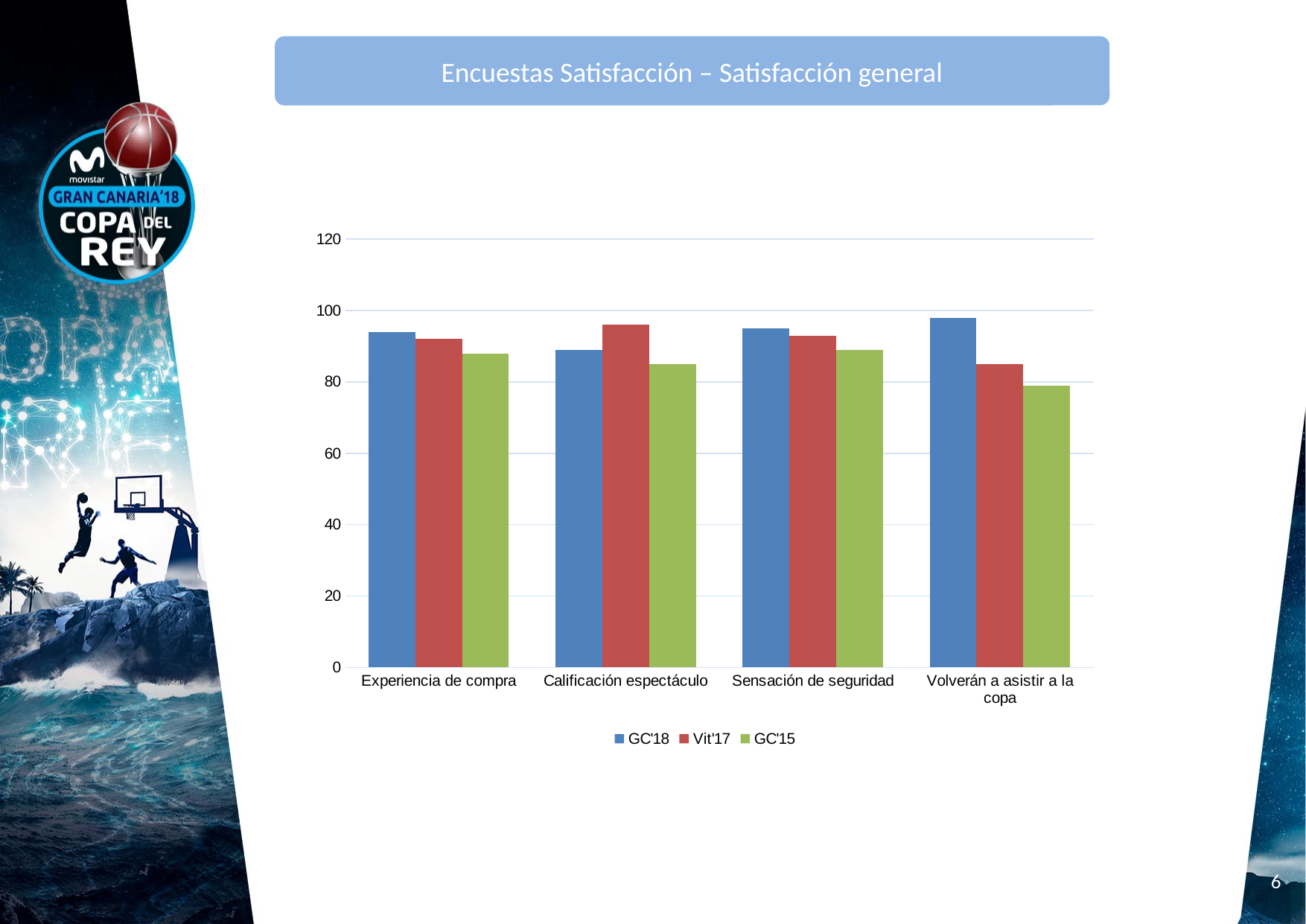
What is the title of the slide containing the chart? Encuestas Satisfacción – Satisfacción general For which category is the GC'18 value lowest? Calificación espectáculo How many series does the chart's legend list? 3 What kind of chart is shown on the slide? bar chart For Calificación espectáculo, which is larger: the GC'18 value or the Vit'17 value? Vit'17 For which category is the GC'15 value lowest? Volverán a asistir a la copa Which series are listed in the chart's legend? GC'18, Vit'17, GC'15 For which category is the GC'18 value highest? Volverán a asistir a la copa Is the GC'15 value for Volverán a asistir a la copa greater or less than 60? greater Is the Vit'17 value for Calificación espectáculo greater or less than 80? greater How many categories are shown on the x axis of the chart? 4 For Volverán a asistir a la copa, which is larger: the GC'18 value or the GC'15 value? GC'18